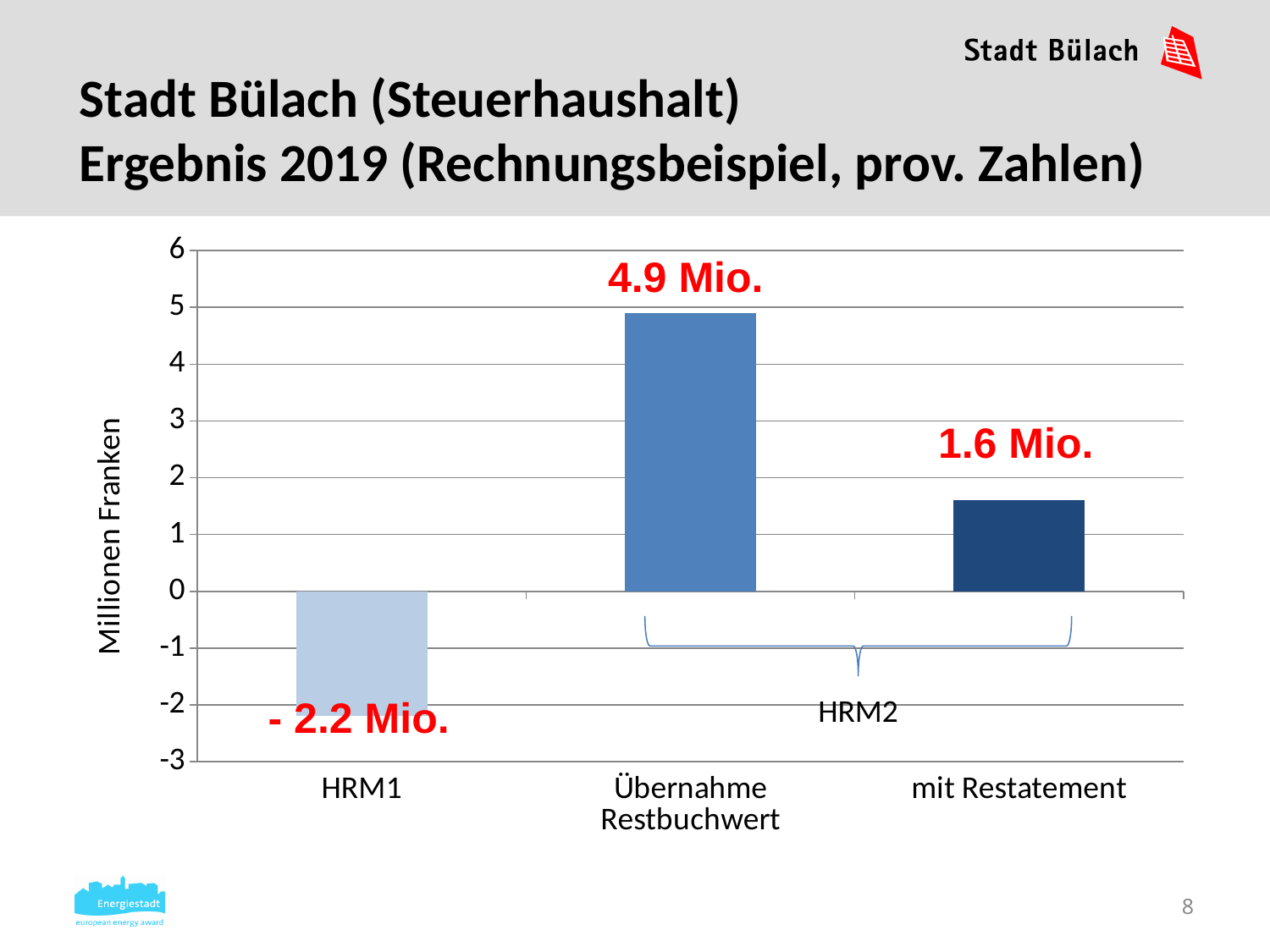
Is the value for Übernahme Restbuchwert greater or less than 4? greater How many categories are shown on the x axis? 3 Which category has the highest value? Übernahme Restbuchwert Which is larger, the value for mit Restatement or the value for HRM1? mit Restatement What is the value shown for Übernahme Restbuchwert? 4.9 Mio. Is the value for HRM1 greater or less than -1? less What is the label of the vertical axis? Millionen Franken Which category has the lowest value? HRM1 What is the value shown for mit Restatement? 1.6 Mio. What is the difference between the values for Übernahme Restbuchwert and mit Restatement? 3.3 Mio. What kind of chart is shown on the slide? bar chart What is the value shown for HRM1? - 2.2 Mio.